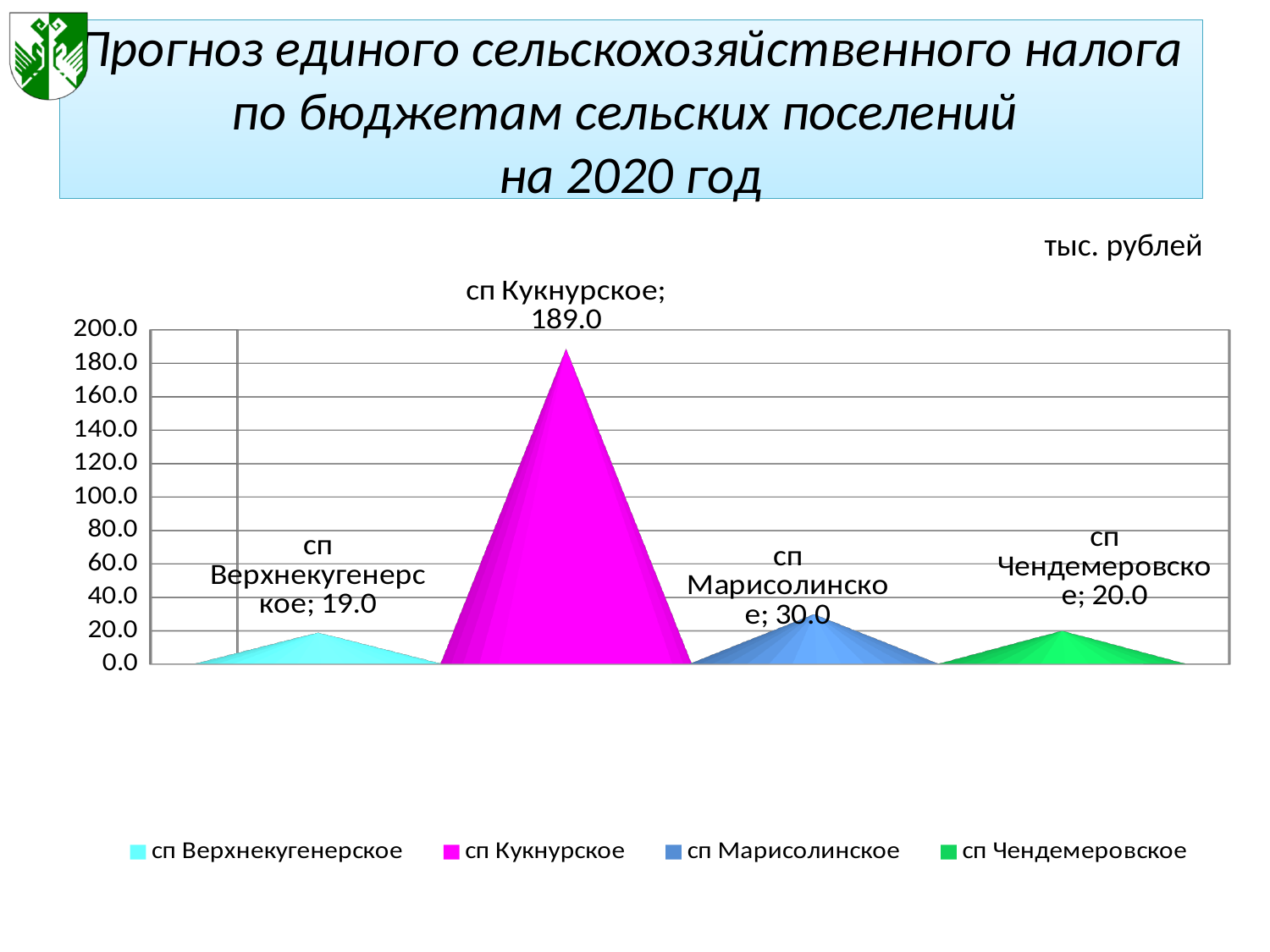
What is the forecast value for сп Чендемеровское? 20.0 How many settlements are shown in the chart? 4 What is the forecast value for сп Кукнурское? 189.0 Which is larger, the value for сп Марисолинское or сп Чендемеровское? сп Марисолинское What kind of chart is shown on the slide? pyramid chart Which settlement has the highest forecast value? сп Кукнурское What unit of measurement is indicated above the chart? тыс. рублей Which settlement has the lowest forecast value? сп Верхнекугенерское How many entries does the legend list? 4 What is the forecast value for сп Марисолинское? 30.0 What is the forecast value for сп Верхнекугенерское? 19.0 What is the difference between the values for сп Кукнурское and сп Марисолинское? 159.0